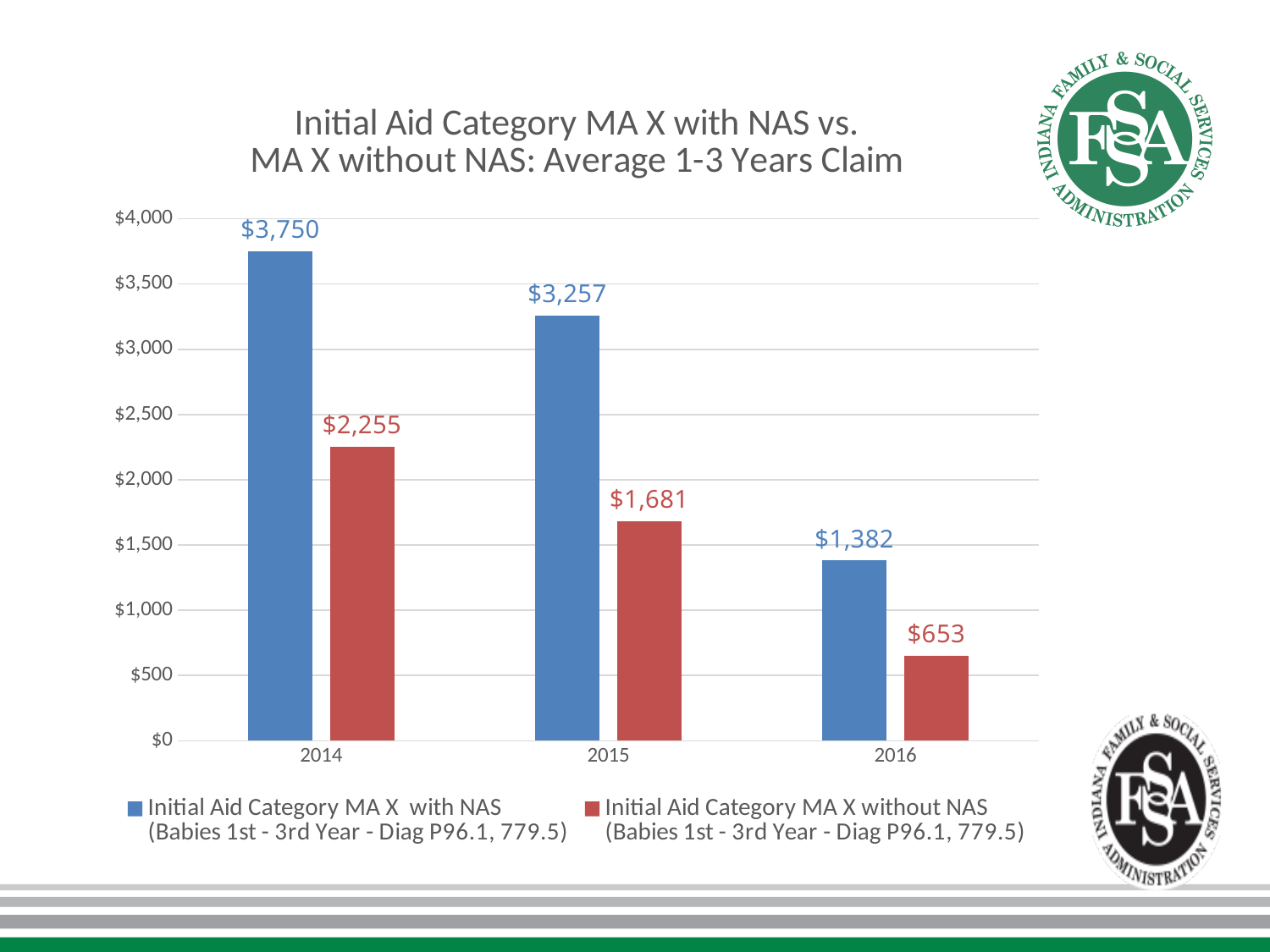
What is the average 1-3 years claim for Initial Aid Category MA X with NAS in 2014? $3,750 In 2016, which is larger: the value for MA X with NAS or MA X without NAS? MA X with NAS What is the difference between the MA X with NAS values for 2015 and 2016? $1,875 What is the average 1-3 years claim for Initial Aid Category MA X without NAS in 2016? $653 Which year has the lowest value for MA X without NAS? 2016 How many series does the legend list? 2 How many years are shown on the x axis? 3 What kind of chart is shown on the slide? Bar chart What is the value for MA X without NAS in 2015? $1,681 Which year has the highest value for MA X with NAS? 2014 What is the difference between the MA X with NAS and MA X without NAS values in 2014? $1,495 Do the values for MA X with NAS rise or fall from 2014 to 2016? Fall